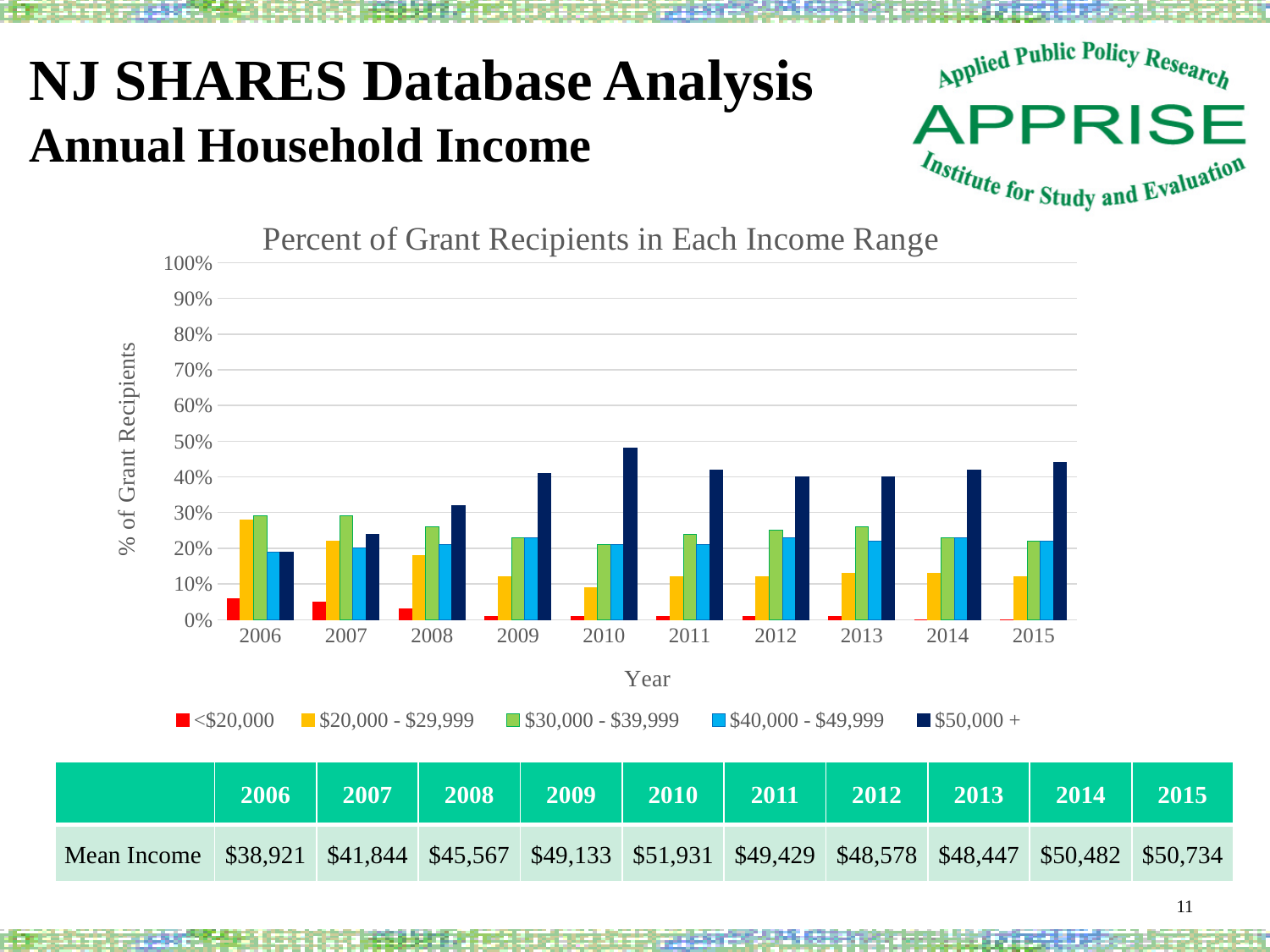
What is the title of the chart? Percent of Grant Recipients in Each Income Range In which year is the $50,000 + share of grant recipients highest? 2010 How many years are shown along the x axis of the chart? 10 Which is larger: the $20,000 - $29,999 share in 2006 or in 2015? 2006 What kind of chart is shown on the slide? bar chart In 2015, which income range has the highest share of grant recipients? $50,000 + Is the value for $30,000 - $39,999 in 2007 greater or less than 20%? greater Is the value for <$20,000 in 2006 greater or less than 10%? less Is the value for $50,000 + in 2010 greater or less than 40%? greater How many income ranges does the chart's legend list? 5 Does the $50,000 + share rise or fall from 2006 to 2010? rise Does the <$20,000 share rise or fall from 2006 to 2015? fall